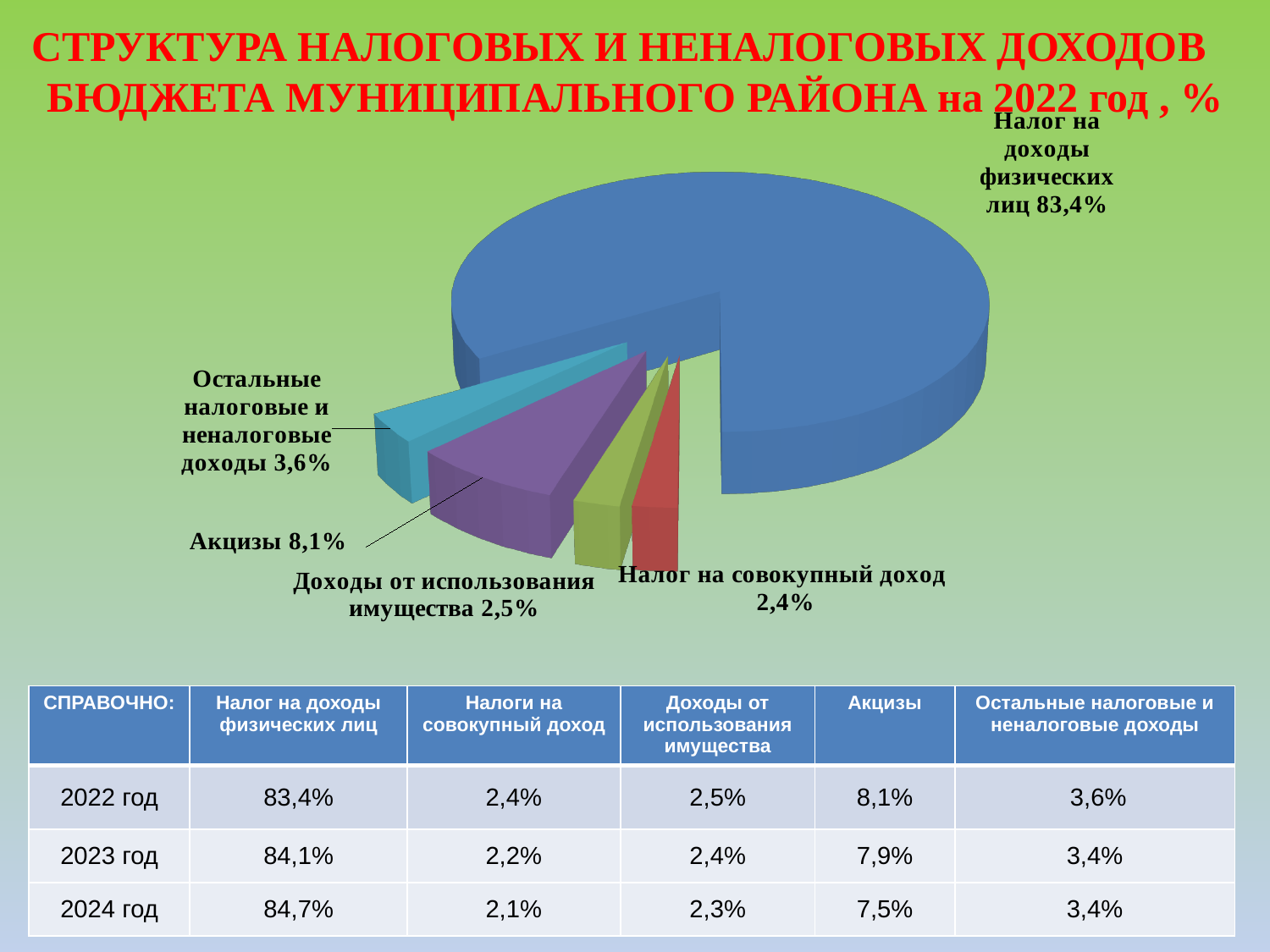
How many slices does the pie chart have? 5 Which slice of the pie chart is the smallest? Налог на совокупный доход What year does the pie chart title say the data is for? 2022 Which is larger in the pie chart: Акцизы or Остальные налоговые и неналоговые доходы? Акцизы Which slice of the pie chart is the largest? Налог на доходы физических лиц By how many percentage points does Акцизы exceed Остальные налоговые и неналоговые доходы in the pie chart? 4,5 What value is shown for Остальные налоговые и неналоговые доходы in the pie chart? 3,6% What value is shown for Доходы от использования имущества in the pie chart? 2,5% What value is shown for Налог на совокупный доход in the pie chart? 2,4% What value is shown for Акцизы in the pie chart? 8,1% What kind of chart is shown on the slide? Pie chart What share of the pie chart is labelled for Налог на доходы физических лиц? 83,4%